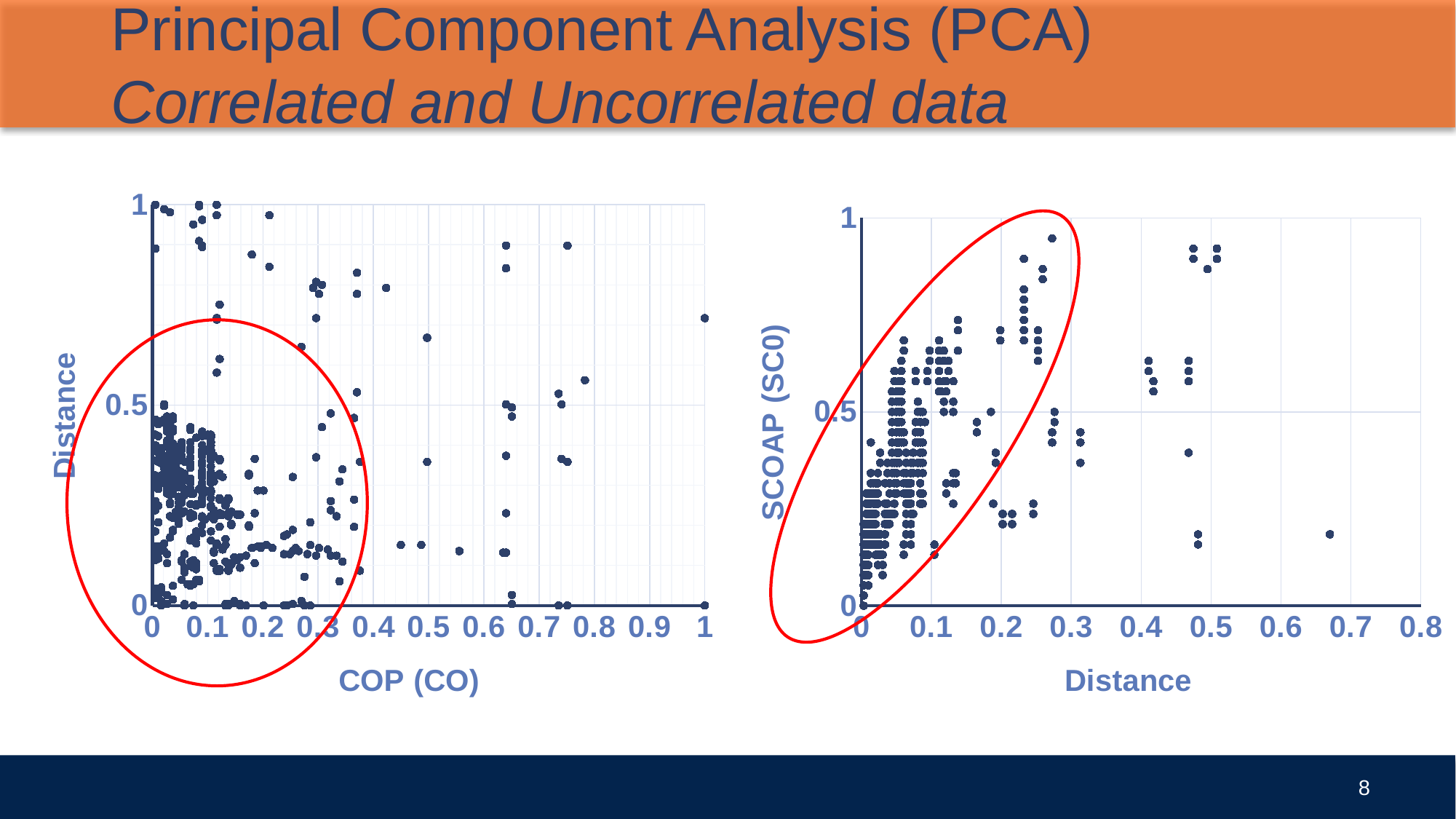
In the right chart (SCOAP vs Distance), do the circled values generally rise or fall as Distance increases? rise What is the highest tick value shown on the x axis of the right chart? 0.8 What is the label of the y axis of the right chart? SCOAP (SC0) What kind of chart is the left chart with x axis COP (CO)? scatter plot In the right chart, is the SCOAP (SC0) value of the point near Distance 0.67 greater or less than 0.5? less What kind of chart is the right chart with x axis Distance? scatter plot How many charts are shown on the slide? 2